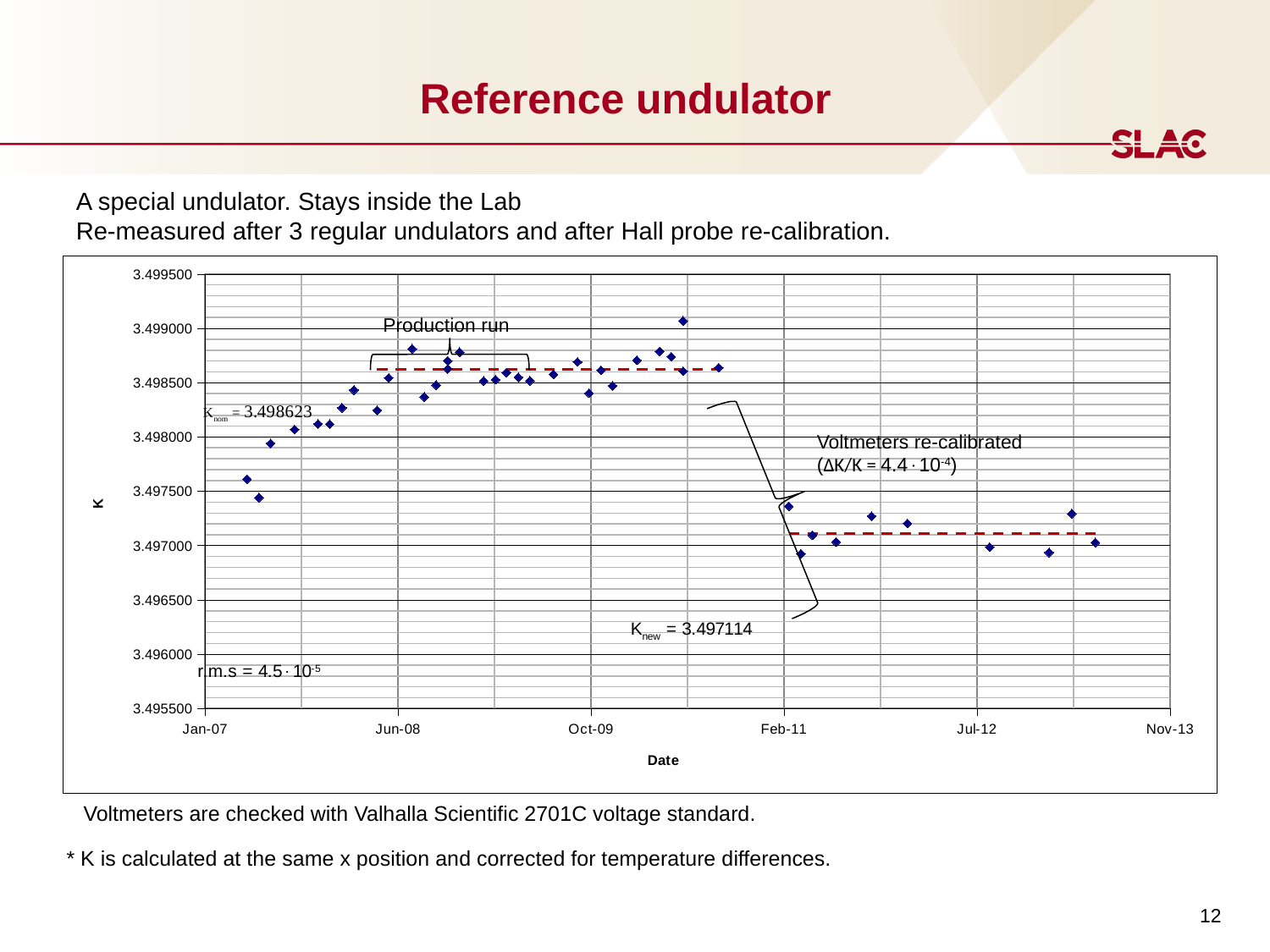
Which is larger, K_nom or K_new? K_nom What is the label of the x axis of the chart? Date What value of K_new is printed on the chart? 3.497114 What kind of chart is shown on the slide? scatter chart What is the label of the y axis of the chart? K What r.m.s value is printed on the chart? 4.5·10^-5 What is the difference between K_nom and K_new as printed on the chart? 0.001509 Do the K values rise or fall between Jan-07 and Jun-08? rise Is the highest plotted K value greater or less than 3.499000? greater Are the K values plotted after Feb-11 greater or less than 3.497500? less What value of K_nom is printed on the chart? 3.498623 What ΔK/K value is given for the voltmeter re-calibration on the chart? 4.4·10^-4